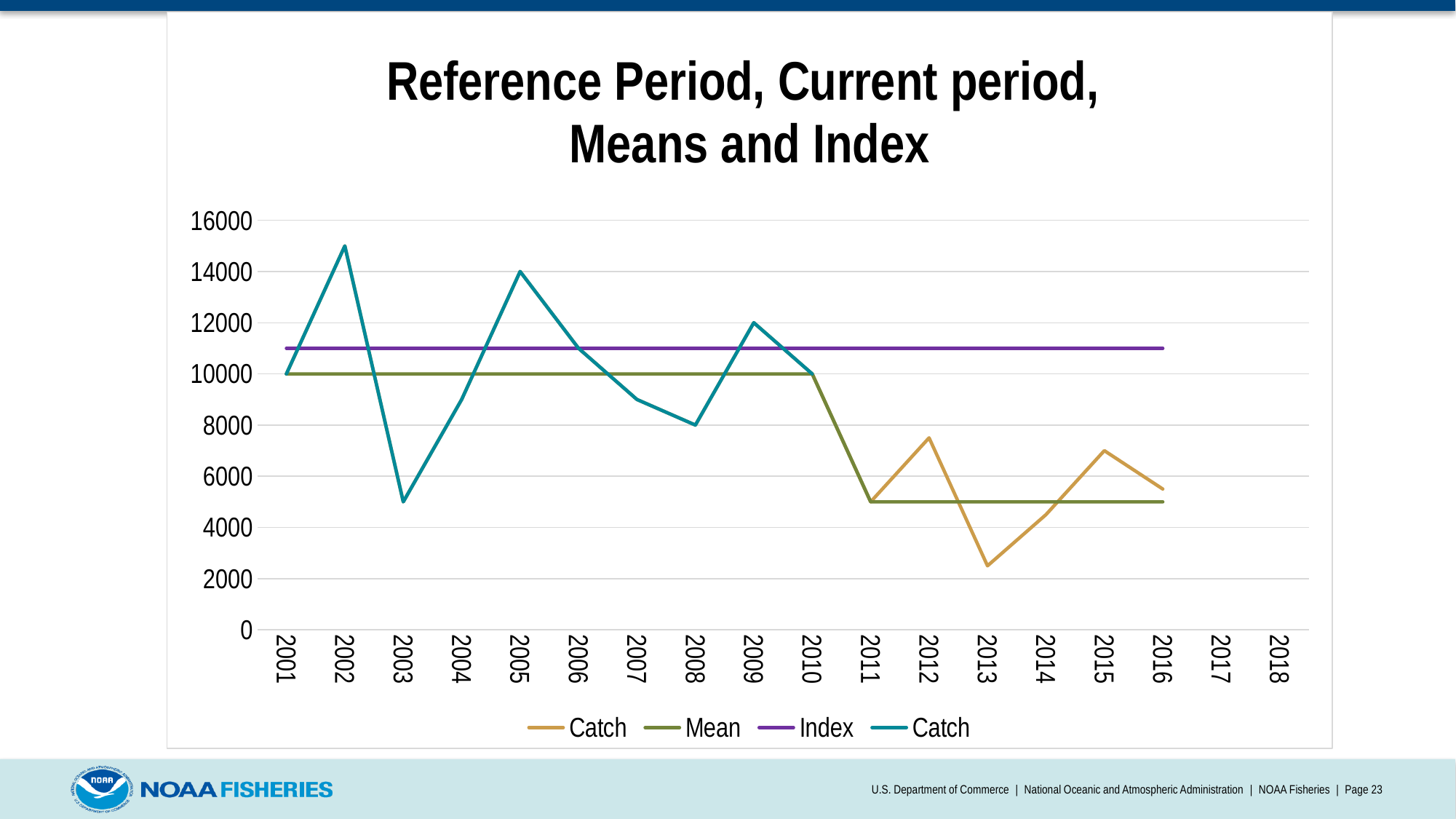
In which year is the Catch highest? 2002 Is the Index value greater or less than 10000? greater Does the Mean line rise or fall between 2010 and 2011? fall What is the Catch value in 2008? 8000 How many years are labelled on the x axis? 18 How many series does the legend list? 4 What is the Mean value in 2001? 10000 Is the Catch value for 2013 greater or less than 4000? less What is the Catch value in 2005? 14000 In which year is the Catch lowest? 2013 What is the Catch value in 2009? 12000 What kind of chart is shown on the slide? line chart